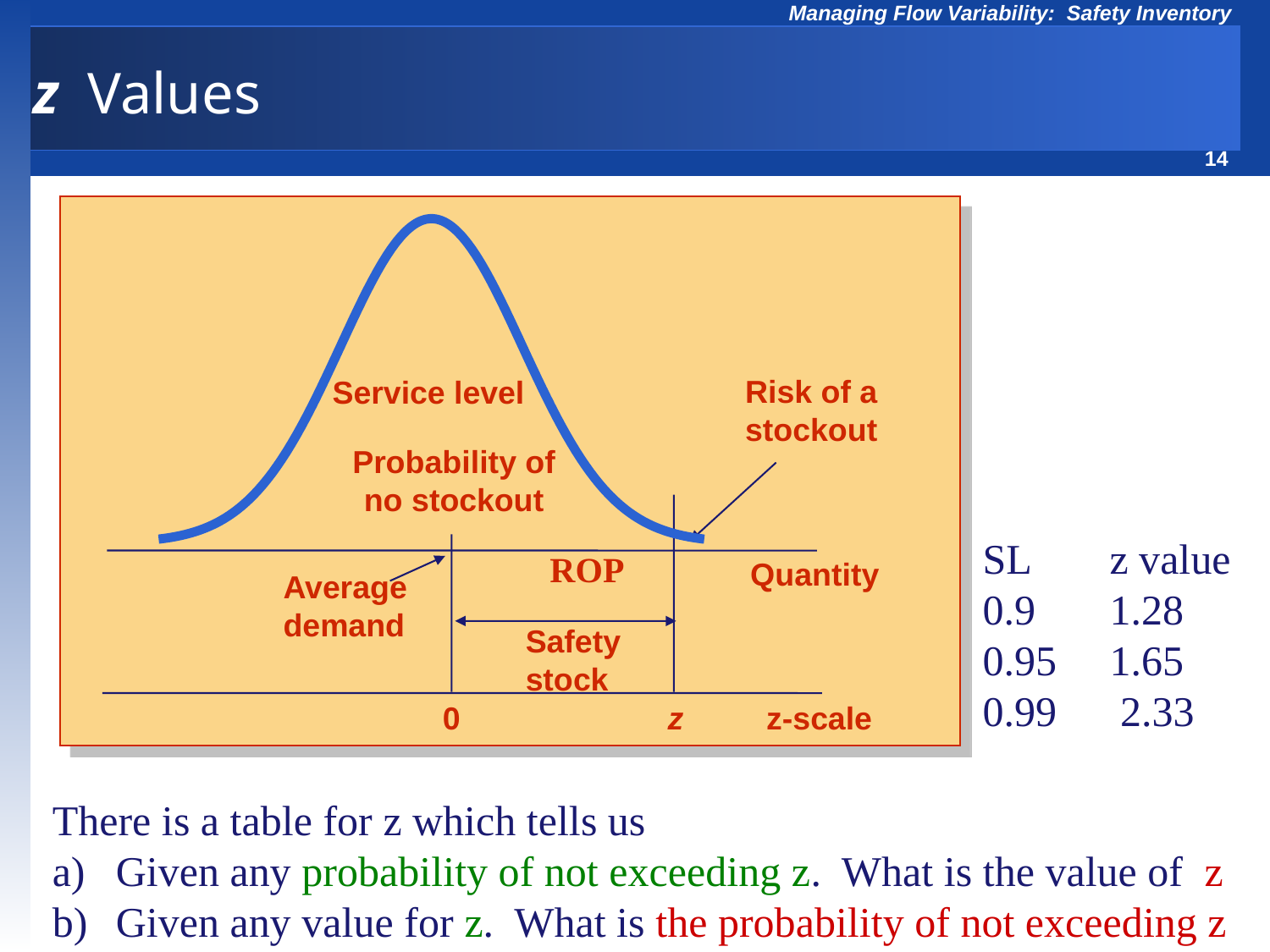
What kind of chart is shown in the diagram on the slide? line chart (bell curve) In the SL / z value table beside the diagram, which SL has the highest z value? 0.99 In the SL / z value table beside the diagram, what is the z value for SL 0.9? 1.28 Moving from left to right along the x axis, does the curve rise or fall after its peak? fall In the SL / z value table beside the diagram, is the z value for SL 0.95 larger or smaller than the z value for SL 0.9? larger What label is printed at the left tick of the z-scale axis, under the average demand line? 0 What does the arrow pointing to the right tail of the curve label? Risk of a stockout In the SL / z value table beside the diagram, which SL has the lowest z value? 0.9 In the SL / z value table beside the diagram, what is the difference between the z values for SL 0.99 and SL 0.95? 0.68 In the SL / z value table beside the diagram, what is the z value for SL 0.95? 1.65 How many tick labels are printed on the z-scale axis of the diagram? 2 What does the area under the curve to the left of z represent, according to the labels in the diagram? Service level (Probability of no stockout)